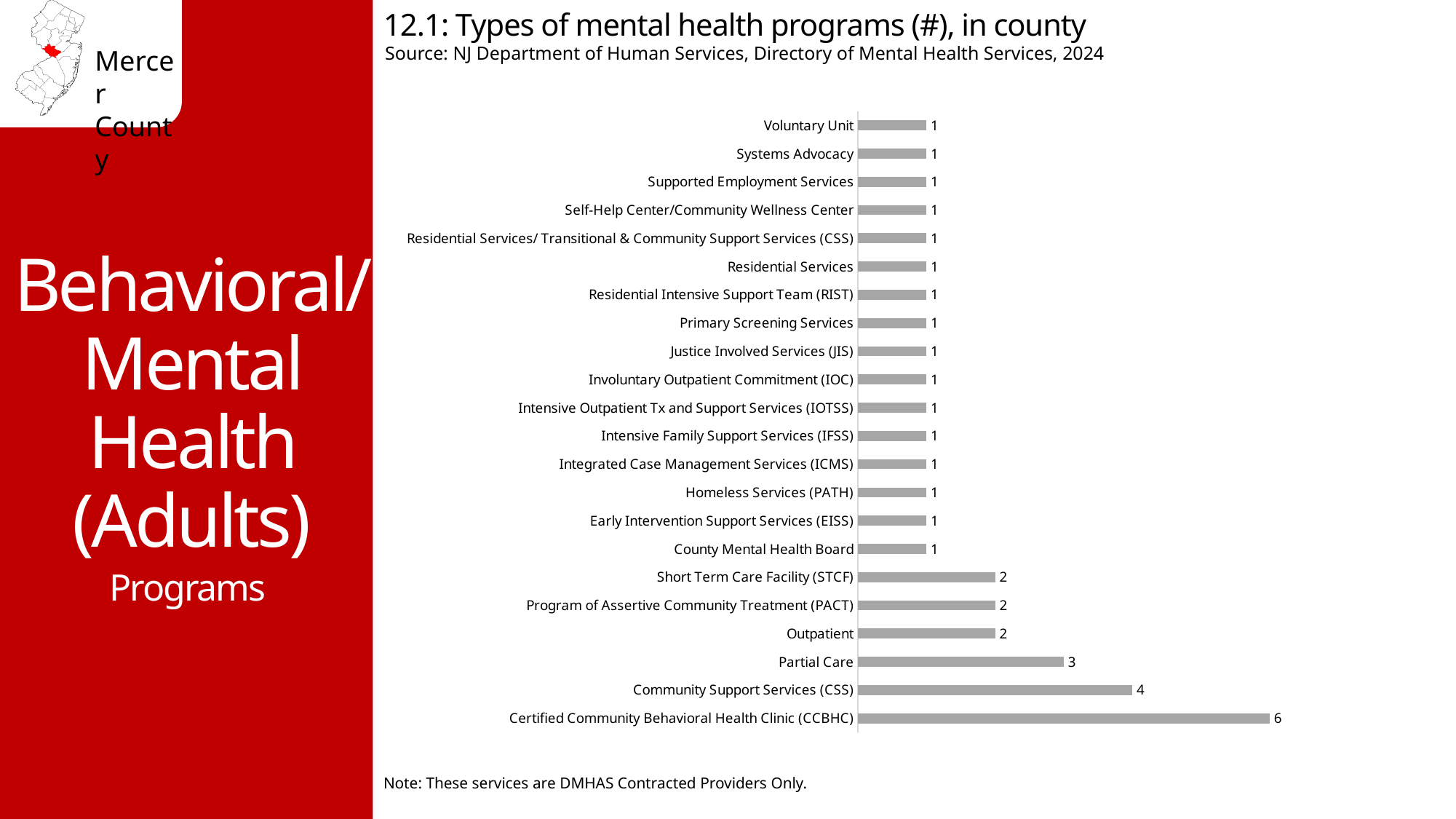
Which is larger, the value for Partial Care or the value for Short Term Care Facility (STCF)? Partial Care What is the title of the chart? 12.1: Types of mental health programs (#), in county How many programs does the Certified Community Behavioral Health Clinic (CCBHC) category have? 6 Which category has the highest number of programs? Certified Community Behavioral Health Clinic (CCBHC) What is the value for Outpatient? 2 What is the value for Community Support Services (CSS)? 4 What kind of chart is shown on the slide? bar chart What is the difference between the values for Community Support Services (CSS) and Program of Assertive Community Treatment (PACT)? 2 How many categories are shown in the chart? 22 What is the value for Partial Care? 3 What is the value for Homeless Services (PATH)? 1 What is the difference between the values for Certified Community Behavioral Health Clinic (CCBHC) and Community Support Services (CSS)? 2